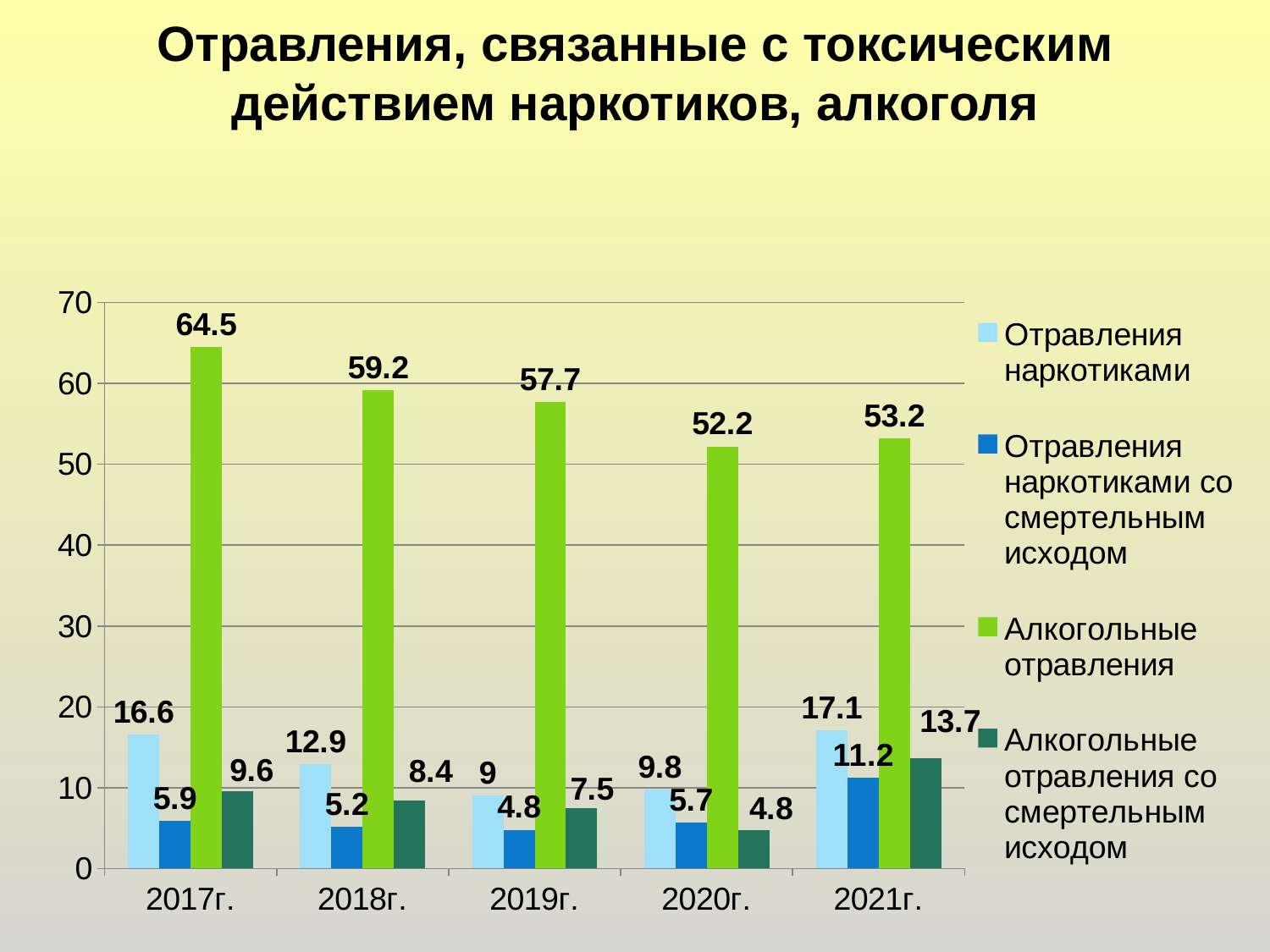
What kind of chart is shown on the slide? bar chart In which year is Алкогольные отравления highest? 2017г. What is the value of Отравления наркотиками со смертельным исходом for 2021г.? 11.2 What is the value of Алкогольные отравления for 2017г.? 64.5 Is the value of Алкогольные отравления for 2019г. greater or less than 50? greater Which is larger: Отравления наркотиками in 2021г. or in 2017г.? 2021г. How many years are shown on the x axis? 5 How many series does the legend list? 4 In which year is Отравления наркотиками lowest? 2019г. What is the difference between Алкогольные отравления in 2017г. and 2020г.? 12.3 Does Алкогольные отравления rise or fall from 2017г. to 2020г.? fall What is the value of Алкогольные отравления со смертельным исходом for 2020г.? 4.8